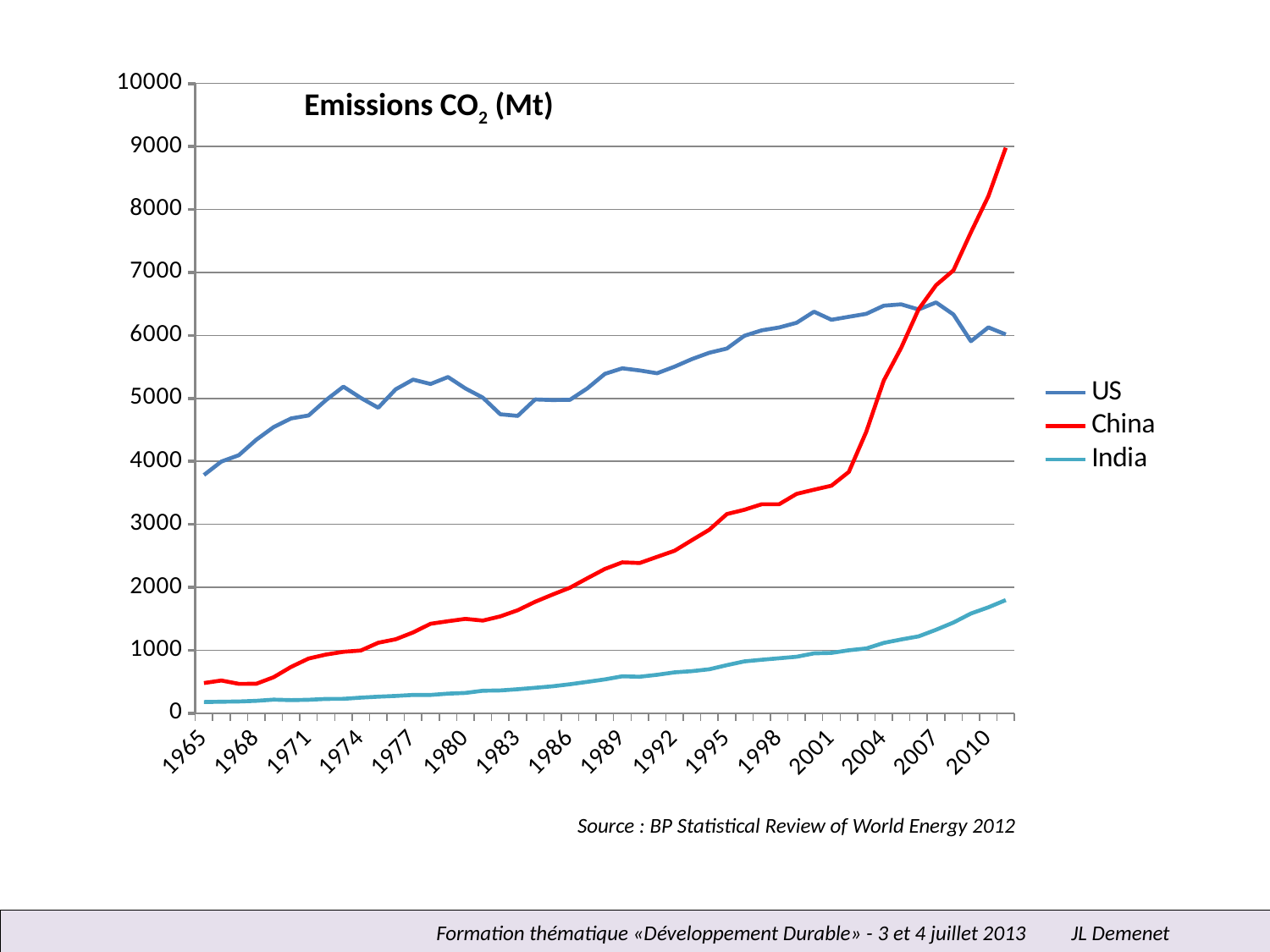
How many series does the legend list? 3 Is the value for India in 2010 greater or less than 2000? less Which series has the lowest value in 1965? India Does the value for India rise or fall from 1965 to 2010? rise What is the title of the chart? Emissions CO2 (Mt) Which is larger in 1995, the value for the US or the value for China? US What kind of chart is shown on the slide? line chart Is the value for China in 2010 greater or less than 7000? greater Is the value for the US in 1965 greater or less than 3000? greater Which series are listed in the legend? US, China, India Which series has the highest value at the right end of the chart (around 2011)? China